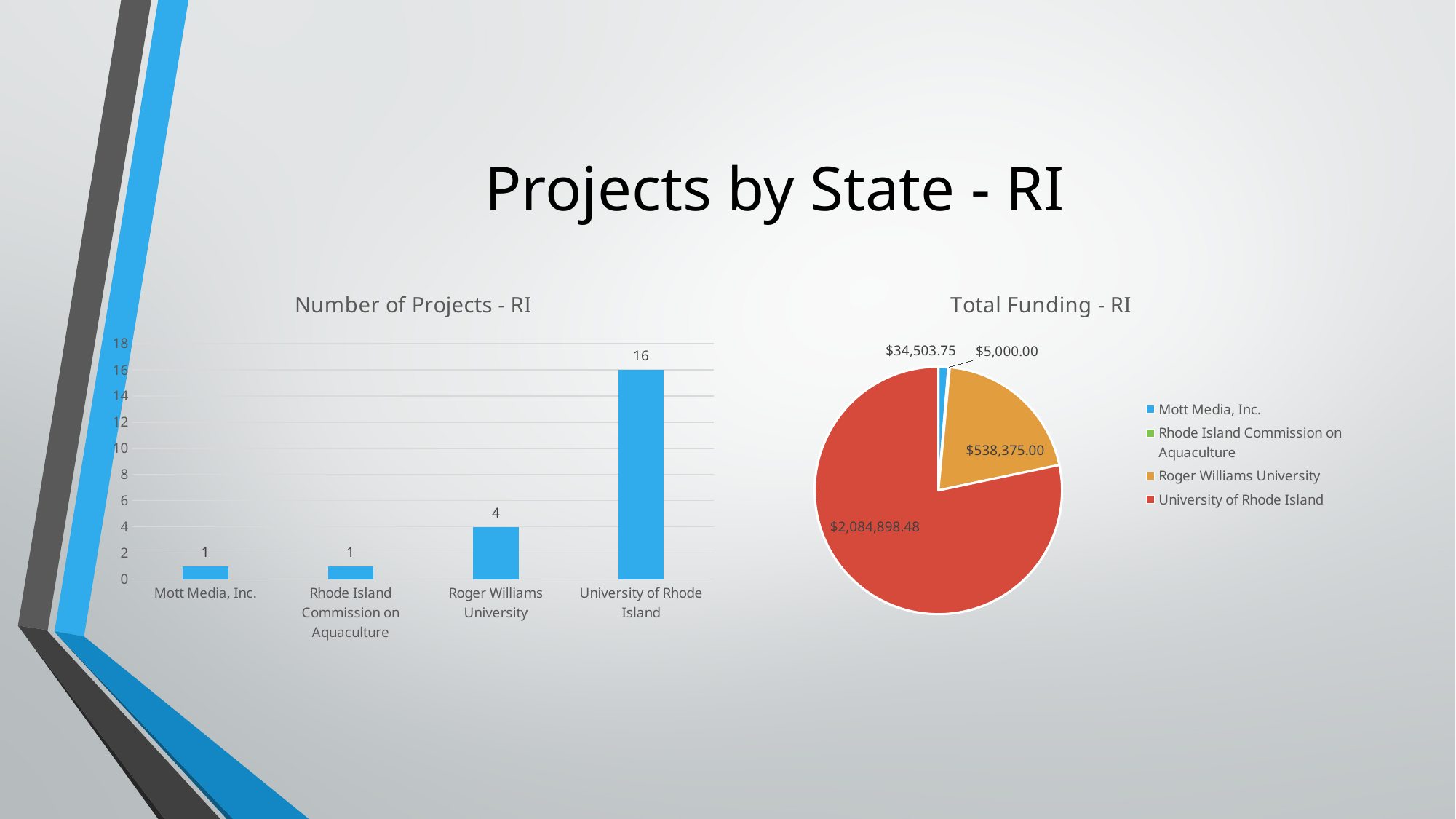
What kind of chart is the Total Funding - RI chart? pie chart In the Total Funding - RI chart, what is the funding for the University of Rhode Island? $2,084,898.48 In the Number of Projects - RI chart, what is the difference between the University of Rhode Island and Roger Williams University? 12 What kind of chart is the Number of Projects - RI chart? bar chart In the Total Funding - RI chart, what is the funding for Roger Williams University? $538,375.00 In the Number of Projects - RI chart, how many projects does Roger Williams University have? 4 In the Number of Projects - RI chart, which category has the highest number of projects? University of Rhode Island In the Number of Projects - RI chart, how many categories are shown on the x axis? 4 In the Total Funding - RI chart, which is larger: the funding for Mott Media, Inc. or for Roger Williams University? Roger Williams University In the Total Funding - RI chart, how many entries does the legend list? 4 In the Number of Projects - RI chart, how many projects does the University of Rhode Island have? 16 In the Total Funding - RI chart, which organization has the smallest funding? Rhode Island Commission on Aquaculture